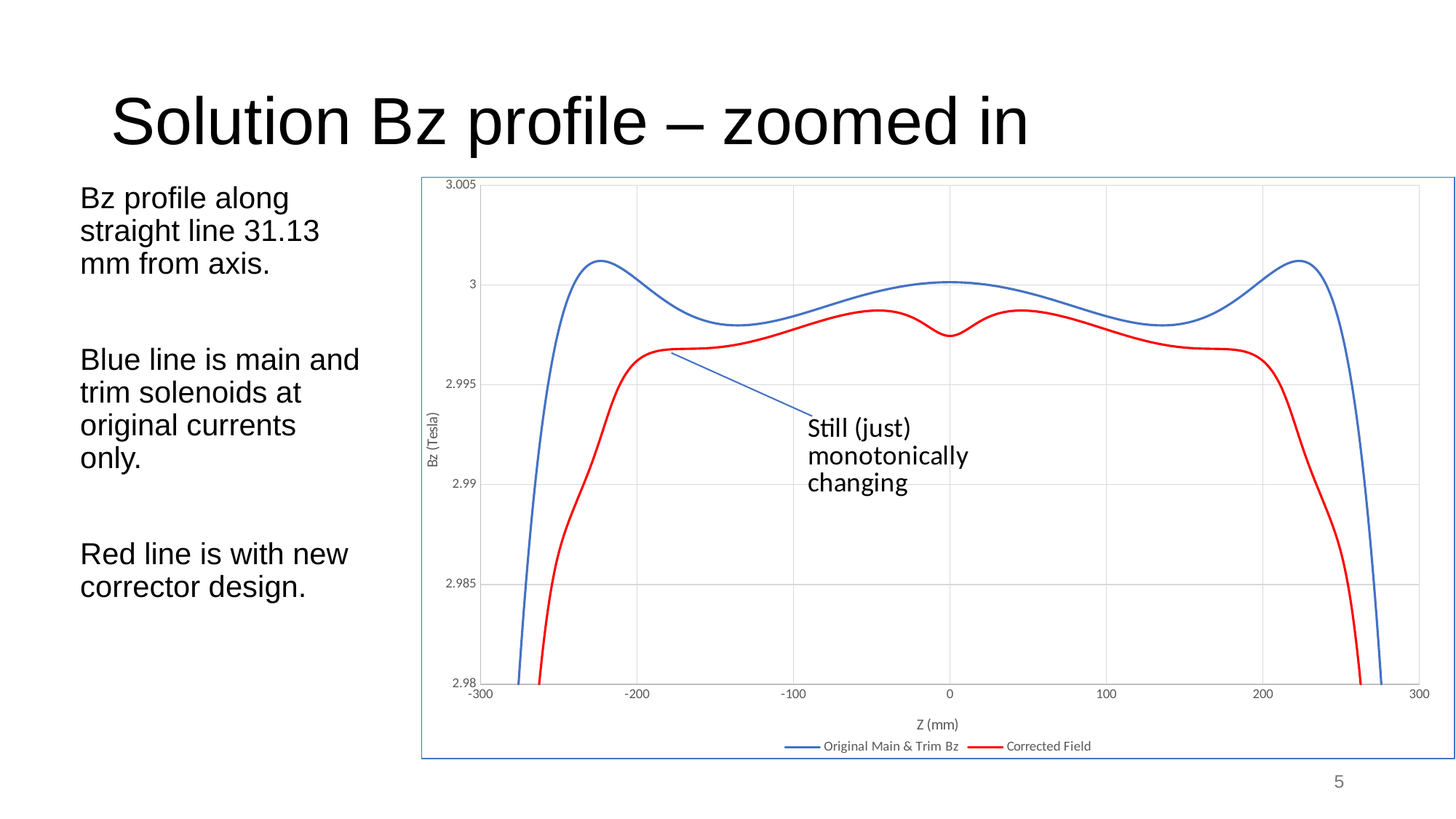
What colour is the Corrected Field line in the chart? Red What are the two series named in the chart legend? Original Main & Trim Bz and Corrected Field Does the Corrected Field line rise or fall as Z goes from -200 to -50? Rise What is the label of the vertical axis of the chart? Bz (Tesla) What is the highest value shown on the vertical axis of the chart? 3.005 Is the value of the Corrected Field line at Z = 0 greater or less than 3? less At Z = 0, which series has the higher Bz value, Original Main & Trim Bz or Corrected Field? Original Main & Trim Bz What kind of chart is shown on the slide? Line chart How many series does the chart legend list? 2 What is the lowest value shown on the vertical axis of the chart? 2.98 Is the peak value of the Original Main & Trim Bz line near Z = -225 greater or less than 3? greater What is the label of the horizontal axis of the chart? Z (mm)